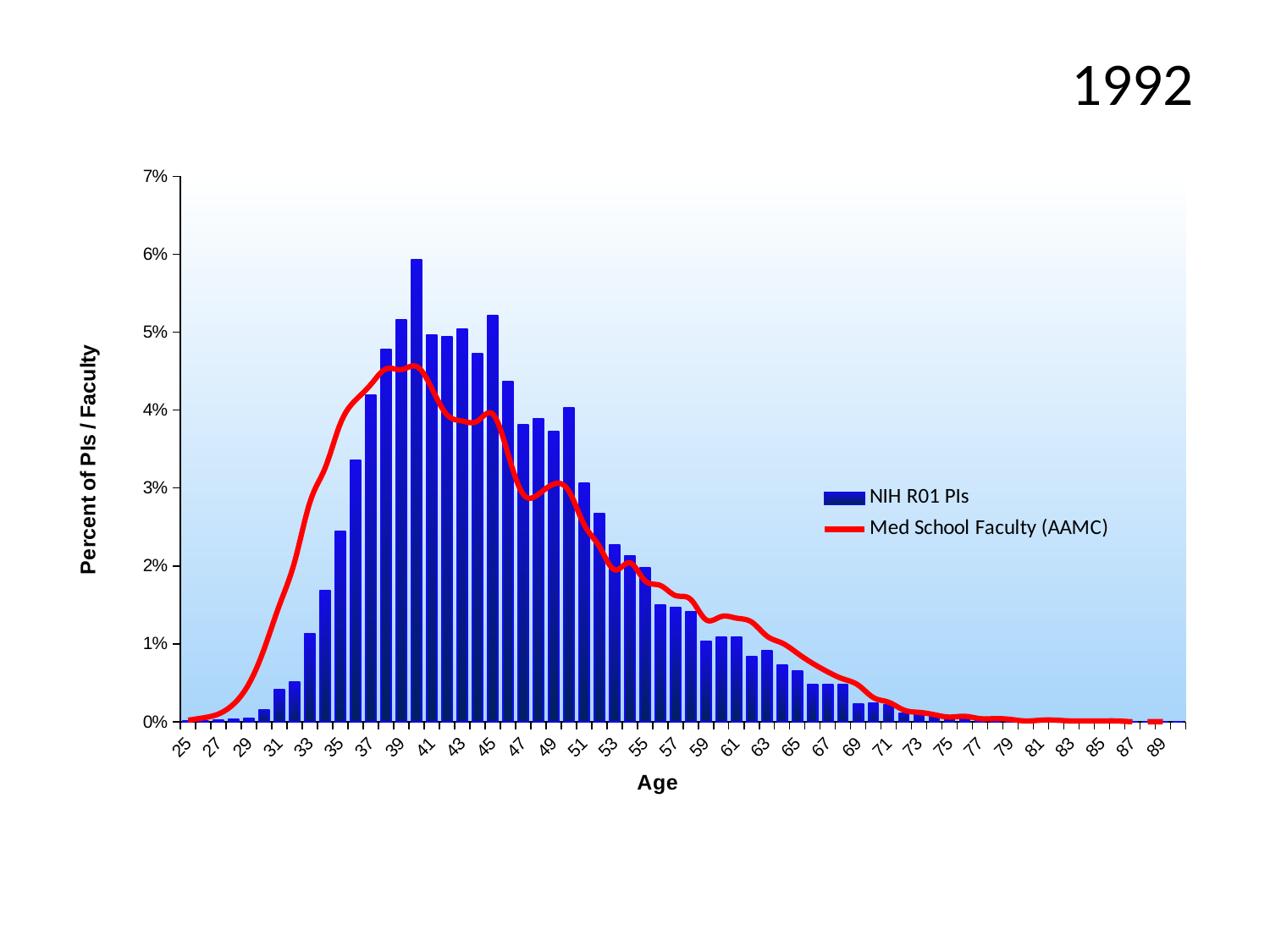
What are the two series named in the legend? NIH R01 PIs and Med School Faculty (AAMC) Is the NIH R01 PIs value at age 45 greater or less than 5%? greater At age 45, which series has the higher value, NIH R01 PIs or Med School Faculty (AAMC)? NIH R01 PIs What kind of chart is shown on the slide? A bar chart with a line series overlaid Is the peak of the Med School Faculty (AAMC) line greater or less than 5%? less At age 33, which series has the higher value, NIH R01 PIs or Med School Faculty (AAMC)? Med School Faculty (AAMC) Is the NIH R01 PIs value at age 31 greater or less than 1%? less What year is shown as the title of the slide? 1992 How many series does the legend list? 2 Do the NIH R01 PIs bars generally rise or fall as age increases from 45 to 65? fall